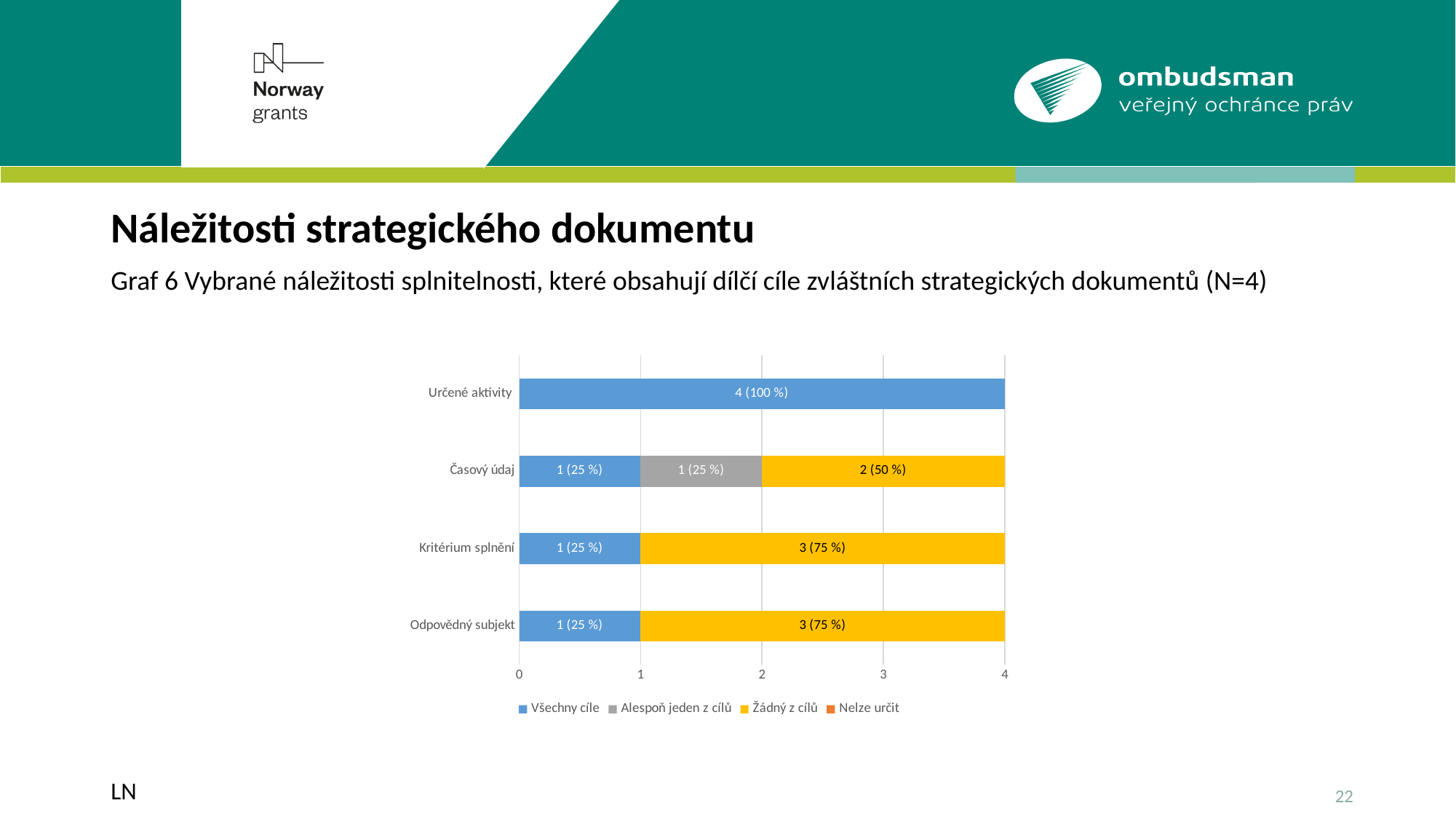
What is the value for "Všechny cíle" in the "Odpovědný subjekt" category? 1 (25 %) What kind of chart is shown on the slide? stacked bar chart What is the value for "Všechny cíle" in the "Určené aktivity" category? 4 (100 %) What is the value for "Žádný z cílů" in the "Časový údaj" category? 2 (50 %) In the "Časový údaj" category, which is larger: the "Žádný z cílů" value or the "Všechny cíle" value? Žádný z cílů What is the total of the stacked bar for "Odpovědný subjekt"? 4 How many series does the chart legend list? 4 What is the value for "Žádný z cílů" in the "Kritérium splnění" category? 3 (75 %) What is the difference between the "Žádný z cílů" value and the "Všechny cíle" value in the "Kritérium splnění" category? 2 What is the value for "Alespoň jeden z cílů" in the "Časový údaj" category? 1 (25 %) Which category has the highest value for the "Všechny cíle" series? Určené aktivity How many categories are plotted on the chart? 4